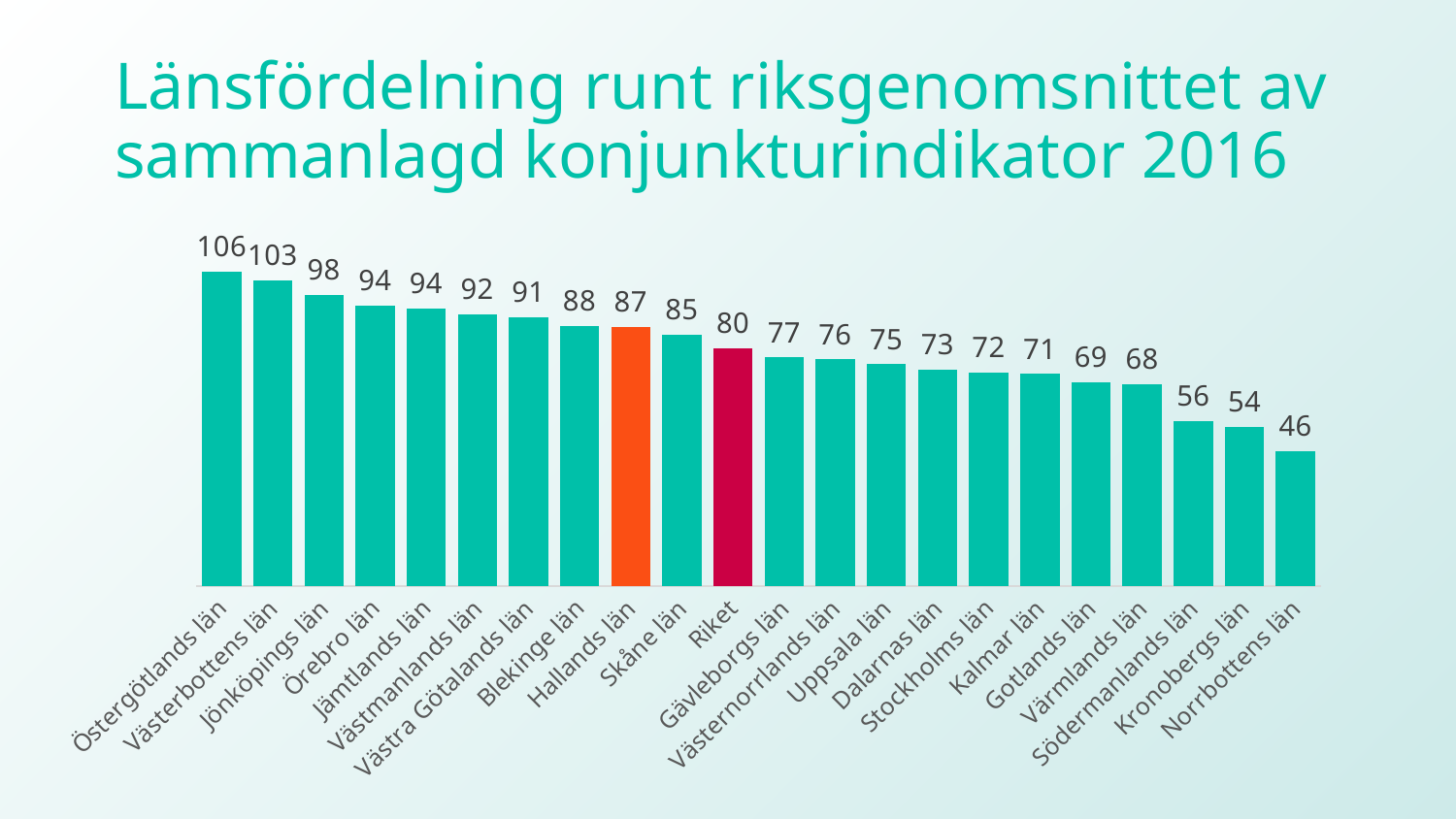
What is the value for Riket? 80 What is the difference between the values for Östergötlands län and Norrbottens län? 60 What is the value for Stockholms län? 72 What is the value for Östergötlands län? 106 What is the value for Hallands län? 87 Which has a larger value, Skåne län or Gävleborgs län? Skåne län What kind of chart is shown on the slide? Bar chart Which category has the highest value? Östergötlands län Do the values rise or fall from left to right along the x axis? Fall How many bars are shown in the chart? 22 What is the difference between the values for Hallands län and Riket? 7 Which category has the lowest value? Norrbottens län